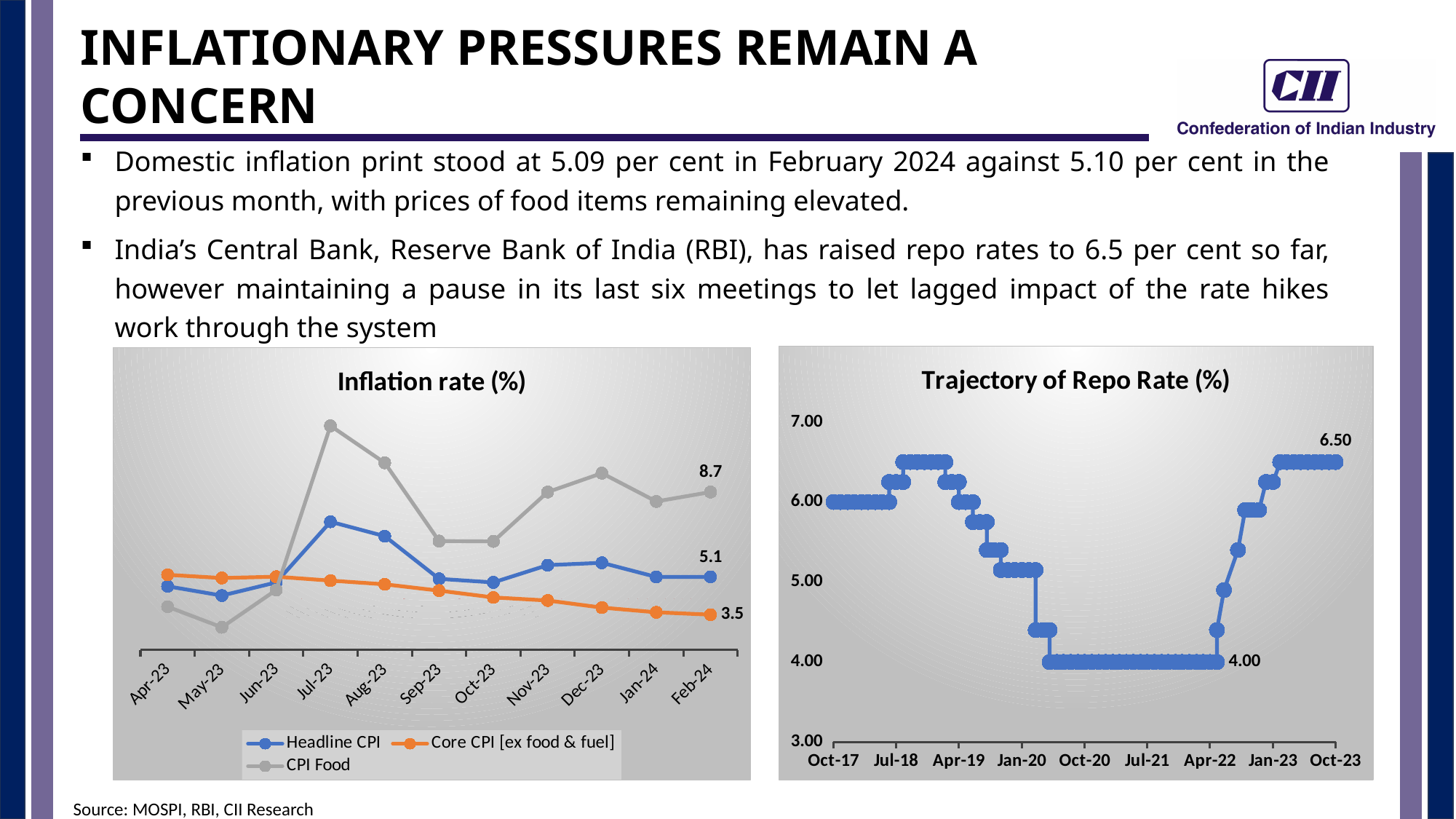
In the 'Trajectory of Repo Rate (%)' chart, what is the lowest repo rate shown? 4.00 What kind of chart is the 'Inflation rate (%)' chart? Line chart In the 'Inflation rate (%)' chart, in which month does CPI Food reach its highest point? Jul-23 How many series does the legend of the 'Inflation rate (%)' chart list? 3 How many months are shown on the x axis of the 'Inflation rate (%)' chart? 11 In the 'Inflation rate (%)' chart, what is the CPI Food value for Feb-24? 8.7 In the 'Inflation rate (%)' chart, what is the Core CPI [ex food & fuel] value for Feb-24? 3.5 In the 'Inflation rate (%)' chart, what is the difference between CPI Food and Headline CPI in Feb-24? 3.6 In the 'Trajectory of Repo Rate (%)' chart, what is the repo rate at the end of the series? 6.50 In the 'Inflation rate (%)' chart, what is the Headline CPI value for Feb-24? 5.1 In the 'Trajectory of Repo Rate (%)' chart, is the repo rate at Oct-17 greater or less than 5.00? greater In the 'Inflation rate (%)' chart, which series has the lowest value in Feb-24? Core CPI [ex food & fuel]